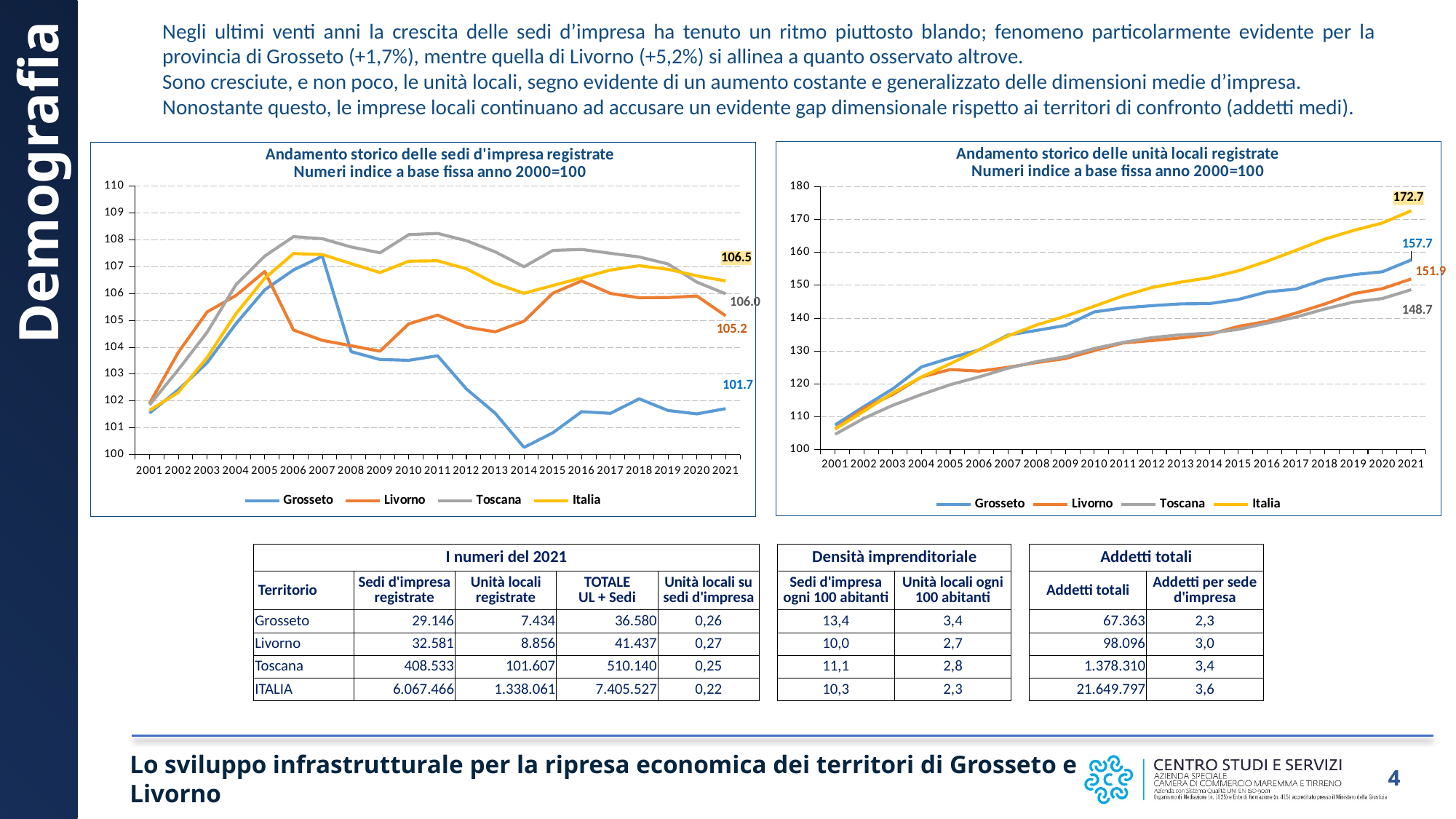
How many years are shown on the x axis of the chart 'Andamento storico delle unità locali registrate'? 21 What kind of chart is 'Andamento storico delle unità locali registrate'? Line chart In the chart 'Andamento storico delle sedi d'impresa registrate', what is the 2021 value for Grosseto? 101.7 In the chart 'Andamento storico delle sedi d'impresa registrate', which series has the lowest value in 2021? Grosseto In the chart 'Andamento storico delle unità locali registrate', which series has the highest value in 2021? Italia In the chart 'Andamento storico delle sedi d'impresa registrate', what is the 2021 value for Italia? 106.5 In the chart 'Andamento storico delle unità locali registrate', is the value for Italia in 2015 greater or less than 150? greater In the chart 'Andamento storico delle unità locali registrate', what is the difference between the 2021 values of Italia and Toscana? 24.0 In the chart 'Andamento storico delle sedi d'impresa registrate', is the value for Grosseto in 2014 greater or less than 101? less In the chart 'Andamento storico delle sedi d'impresa registrate', which is larger in 2021: Toscana or Livorno? Toscana How many series does the legend of the chart 'Andamento storico delle sedi d'impresa registrate' list? 4 In the chart 'Andamento storico delle unità locali registrate', what is the 2021 value for Livorno? 151.9